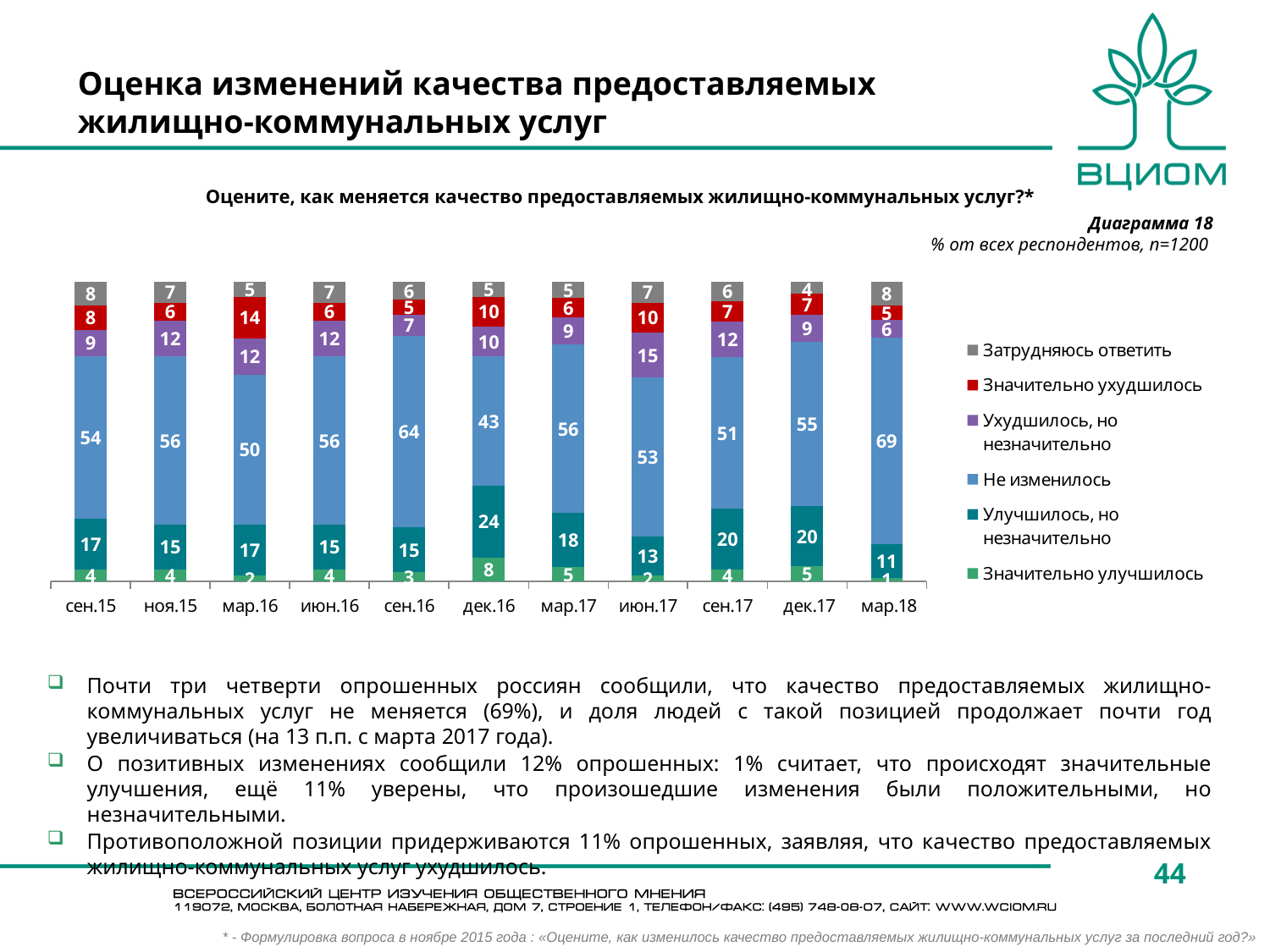
What is the value for "Улучшилось, но незначительно" in дек.16? 24 What is the value for "Значительно ухудшилось" in мар.16? 14 What is the total of the stacked bar for сен.15? 100 What is the value for "Не изменилось" in мар.18? 69 What kind of chart is shown on the slide? stacked bar chart What is the difference between the "Не изменилось" values in мар.18 and мар.17? 13 What is the value for "Ухудшилось, но незначительно" in июн.17? 15 How many series does the legend list? 6 How many time periods are shown on the x axis? 11 In which period is the value for "Не изменилось" the lowest? дек.16 In which period is the value for "Не изменилось" the highest? мар.18 Which is larger: the "Улучшилось, но незначительно" value in сен.17 or in мар.18? сен.17